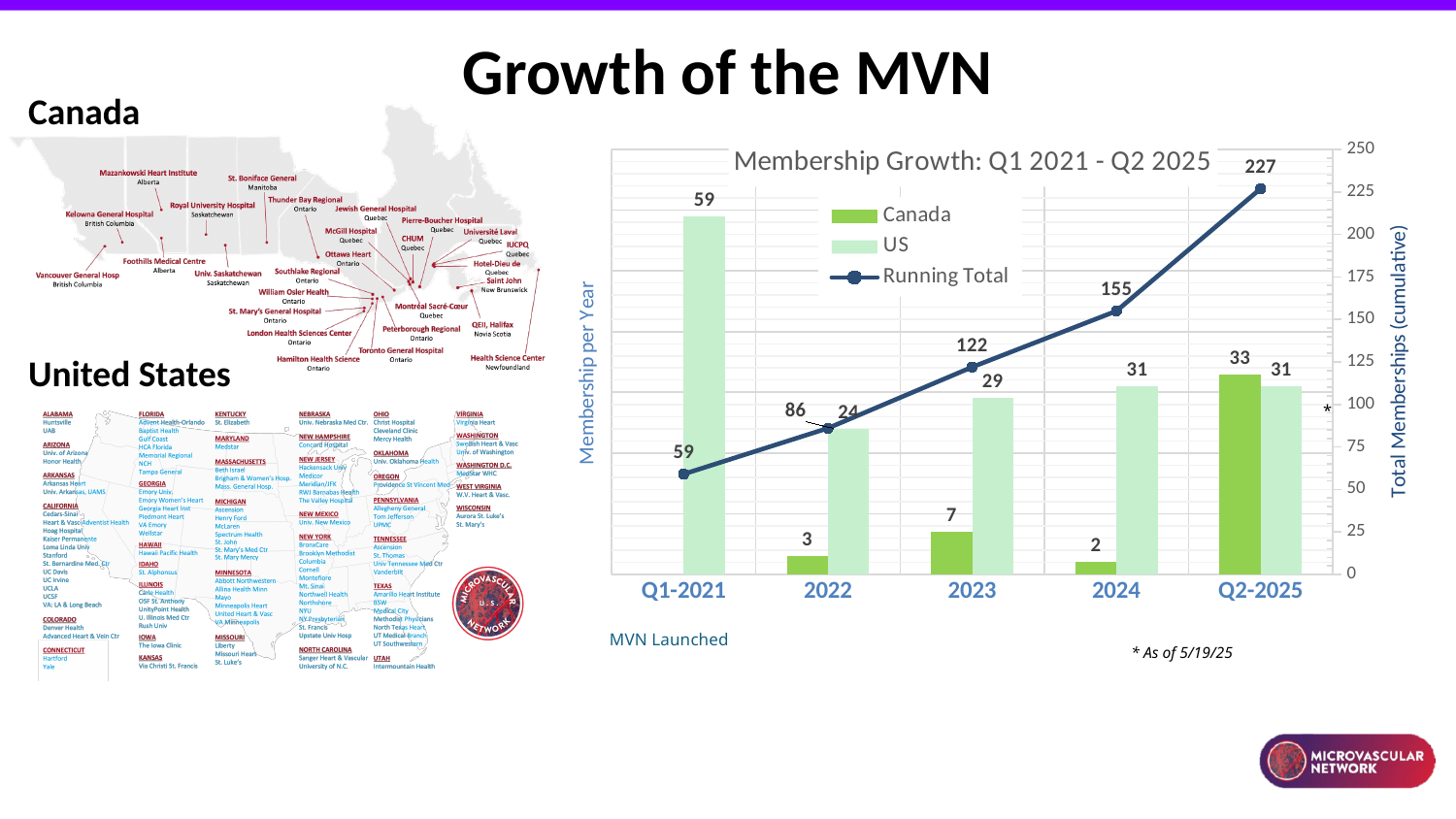
In the Membership Growth chart, which category has the highest Canada value? Q2-2025 What is the title of the chart on the right side of the slide? Membership Growth: Q1 2021 - Q2 2025 In the Membership Growth chart, what is the US value for Q1-2021? 59 In the Membership Growth chart, which year has the lowest Canada value among the labelled Canada bars? 2024 In the Membership Growth chart, does the Running Total rise or fall from Q1-2021 to Q2-2025? rise In the Membership Growth chart, what is the difference between the Running Total for Q2-2025 and for 2024? 72 In the Membership Growth chart, what is the Running Total for Q2-2025? 227 In the Membership Growth chart, what is the Canada value for 2023? 7 In the Membership Growth chart, which is larger for Q2-2025: the Canada value or the US value? Canada In the Membership Growth chart, how many series does the legend list? 3 In the Membership Growth chart, what is the Running Total for 2024? 155 In the Membership Growth chart, how many categories are shown on the x axis? 5